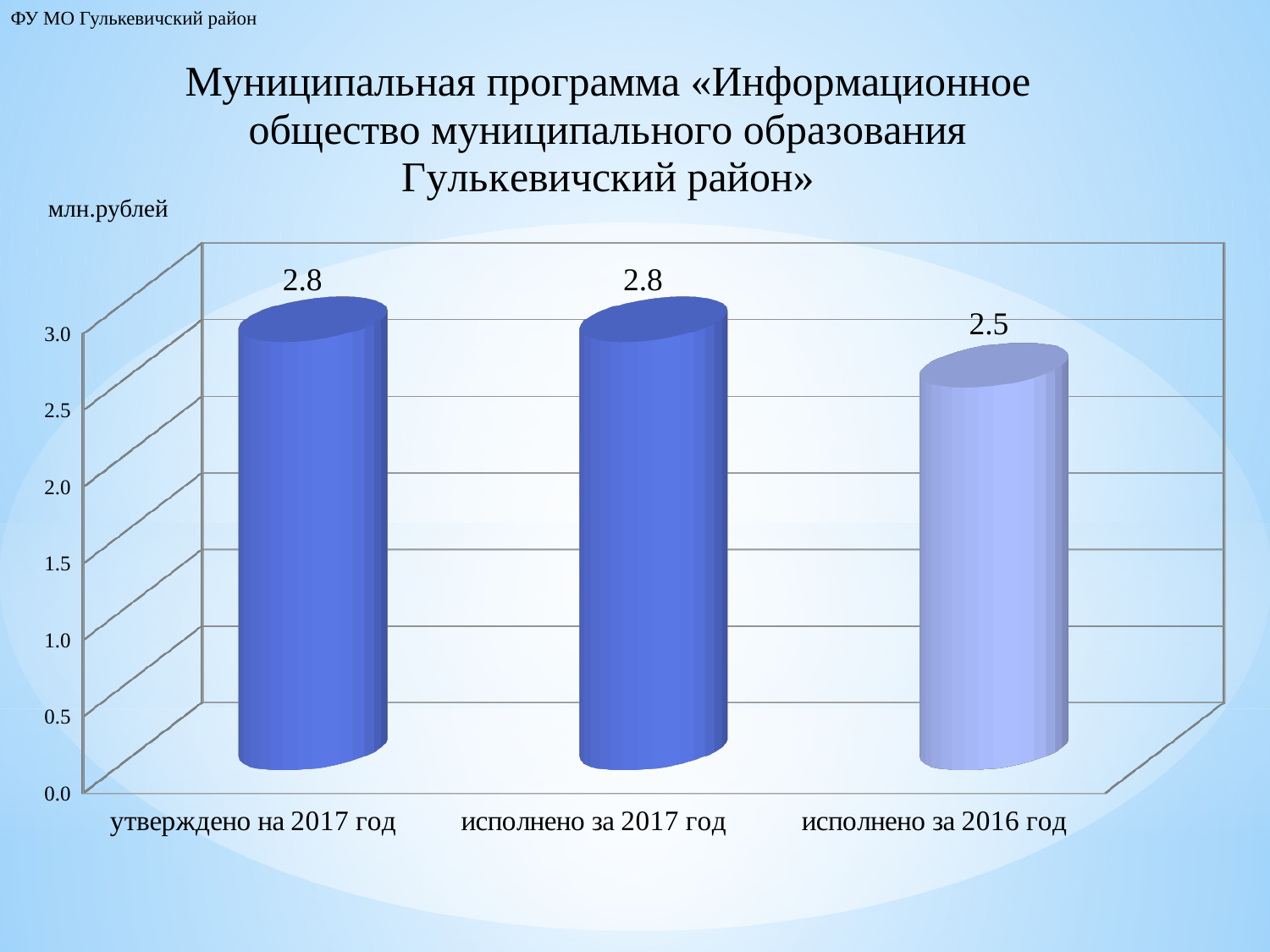
Which category has the lowest value? исполнено за 2016 год What unit of measurement is indicated for the chart values? млн.рублей Is the value for «утверждено на 2017 год» greater or less than 2.0? greater What is the value for «исполнено за 2016 год»? 2.5 How many categories are shown in the chart? 3 What is the title of the chart? Муниципальная программа «Информационное общество муниципального образования Гулькевичский район» What is the value for «утверждено на 2017 год»? 2.8 Which is larger: the value for «утверждено на 2017 год» or the value for «исполнено за 2016 год»? утверждено на 2017 год What is the value for «исполнено за 2017 год»? 2.8 What is the difference between the values for «исполнено за 2017 год» and «исполнено за 2016 год»? 0.3 Is the value for «исполнено за 2016 год» greater or less than 3.0? less What kind of chart is shown on the slide? bar chart